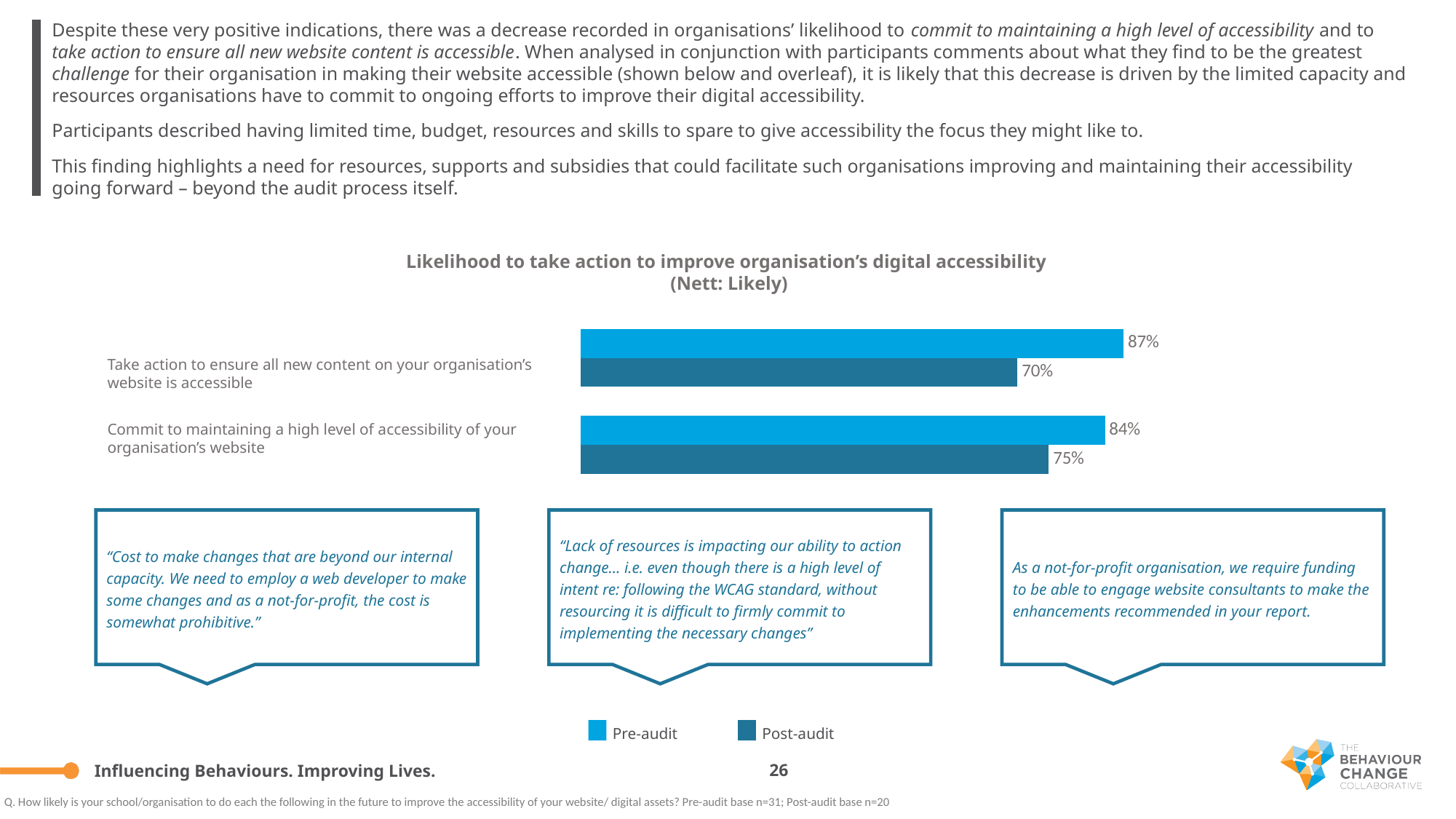
Which is larger: the Post-audit value for 'Take action to ensure all new content' or the Post-audit value for 'Commit to maintaining a high level of accessibility'? Commit to maintaining a high level of accessibility What is the Post-audit value for 'Commit to maintaining a high level of accessibility of your organisation's website'? 75% What is the Post-audit value for 'Take action to ensure all new content on your organisation's website is accessible'? 70% Which category has the highest Pre-audit value? Take action to ensure all new content on your organisation's website is accessible What is the Pre-audit value for 'Commit to maintaining a high level of accessibility of your organisation's website'? 84% How many series does the legend list? 2 What is the Pre-audit value for 'Take action to ensure all new content on your organisation's website is accessible'? 87% Which category has the lowest Post-audit value? Take action to ensure all new content on your organisation's website is accessible What is the difference between the Pre-audit and Post-audit values for 'Commit to maintaining a high level of accessibility of your organisation's website'? 9 percentage points How many categories are shown in the chart? 2 What is the difference between the Pre-audit and Post-audit values for 'Take action to ensure all new content on your organisation's website is accessible'? 17 percentage points What type of chart is shown on the slide? Bar chart